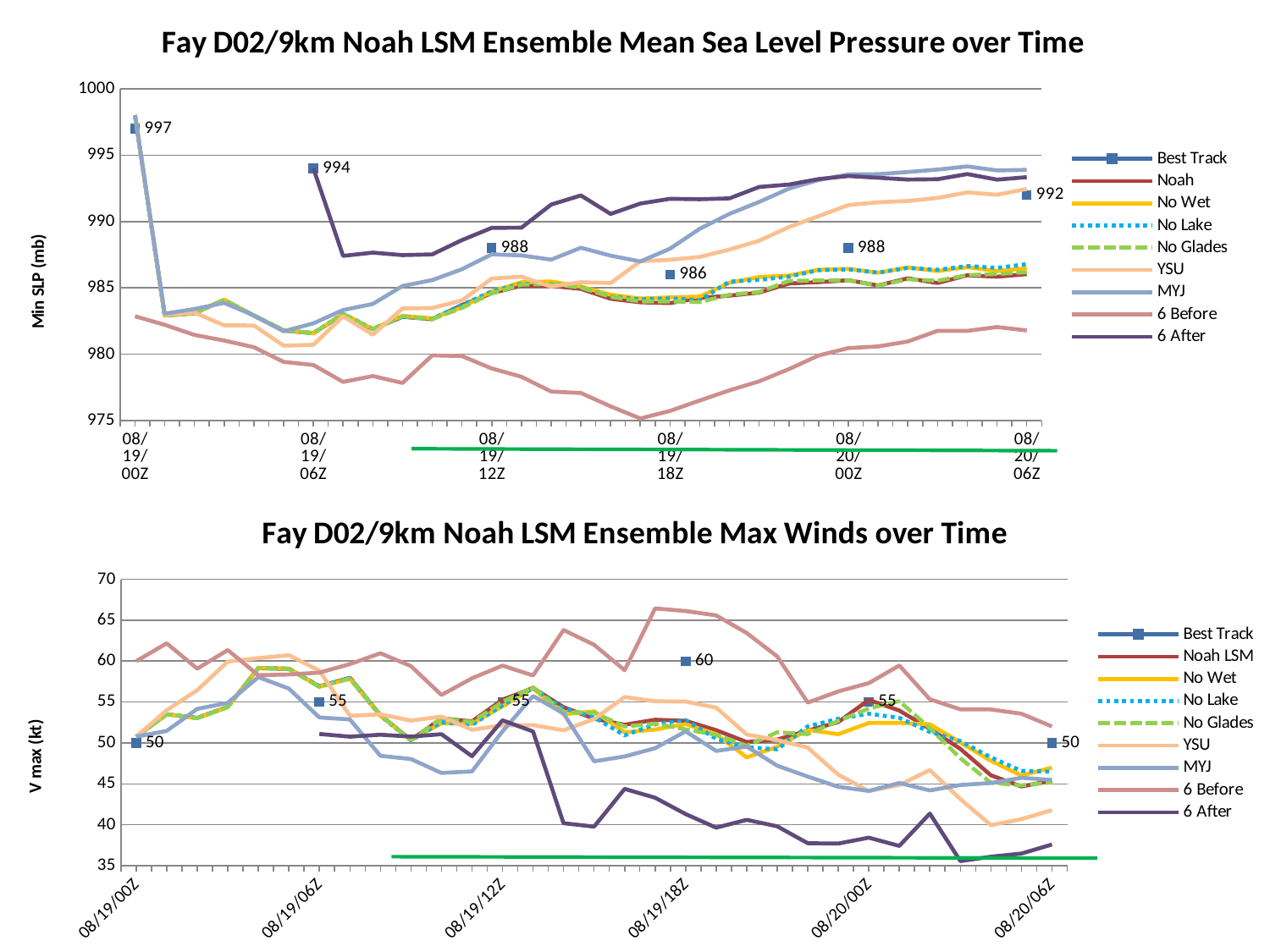
On the Max Winds chart, what is the Best Track value at 08/19/18Z? 60 On the Mean Sea Level Pressure chart, how many series does the legend list? 9 On the Mean Sea Level Pressure chart, what is the Best Track value at 08/20/06Z? 992 On the Max Winds chart, what is the Best Track value at 08/19/00Z? 50 On the Mean Sea Level Pressure chart, what is the Best Track value at 08/19/18Z? 986 On the Mean Sea Level Pressure chart, is the 6 Before value at 08/19/18Z greater or less than 980? less On the Max Winds chart, which labeled Best Track point has the highest value? 60 at 08/19/18Z What type of chart is the Max Winds chart? line chart On the Mean Sea Level Pressure chart, what is the difference between the Best Track values at 08/19/00Z and 08/19/18Z? 11 On the Mean Sea Level Pressure chart, what is the Best Track value at 08/19/00Z? 997 On the Max Winds chart, is the 6 After value at 08/20/06Z greater or less than 40? less On the Mean Sea Level Pressure chart, which labeled Best Track point has the lowest value? 986 at 08/19/18Z